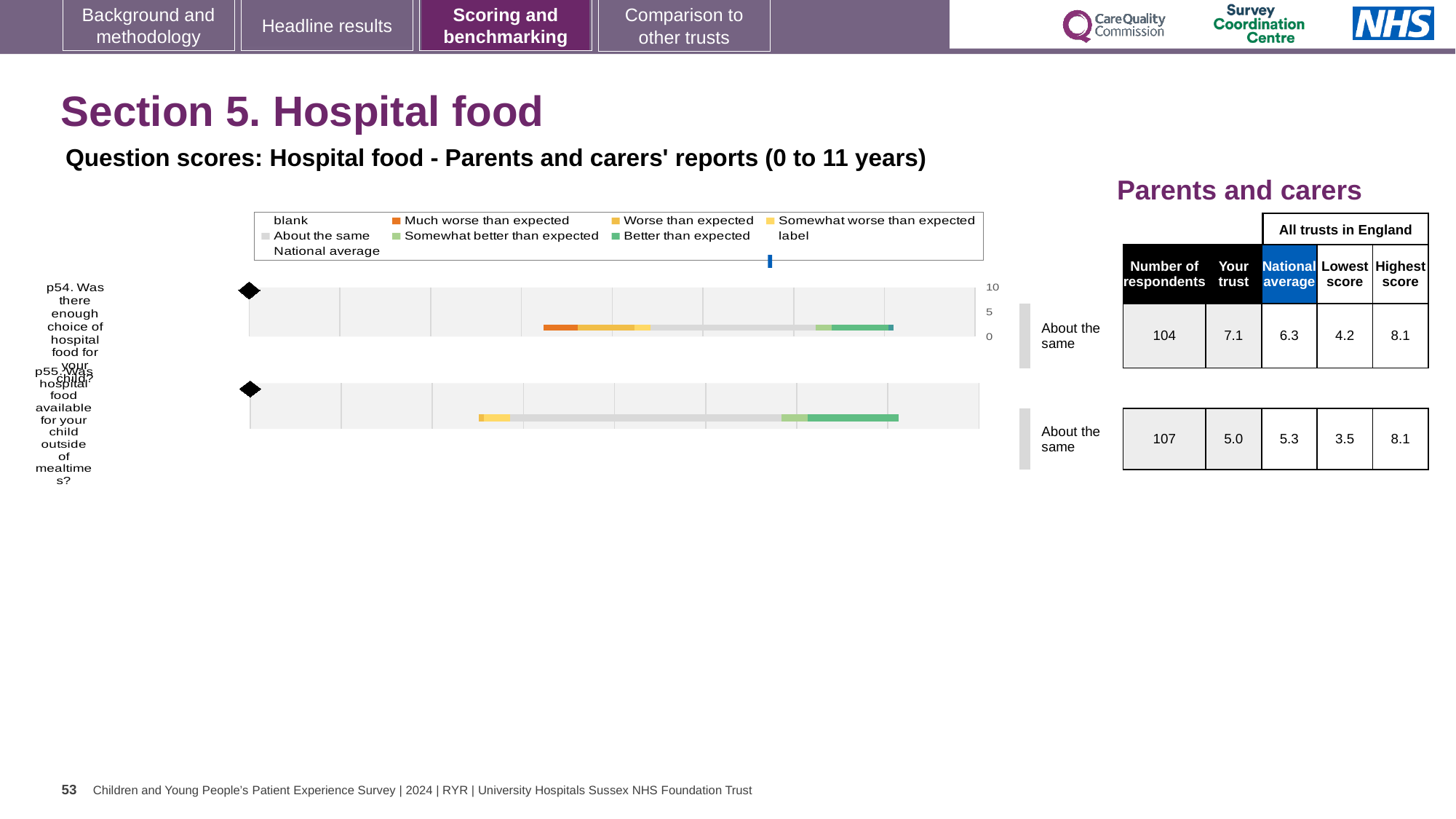
What kind of chart is used for the p54 and p55 question scores? bar chart How many survey questions are plotted in the hospital food charts? 2 What is the highest value shown on the chart's axis? 10 What is the difference between the 'Your trust' scores for p54 and p55? 2.1 For p54 (enough choice of hospital food), what is the 'Your trust' score? 7.1 For p55 (hospital food available outside of mealtimes), what is the 'Your trust' score? 5.0 Which legend entry is shown in orange? Much worse than expected For p54, what is the national average score? 6.3 How many respondents answered p55? 107 Which question has the higher 'Your trust' score, p54 or p55? p54 What is the benchmark category shown for p54? About the same For p55, what is the lowest score among all trusts in England? 3.5